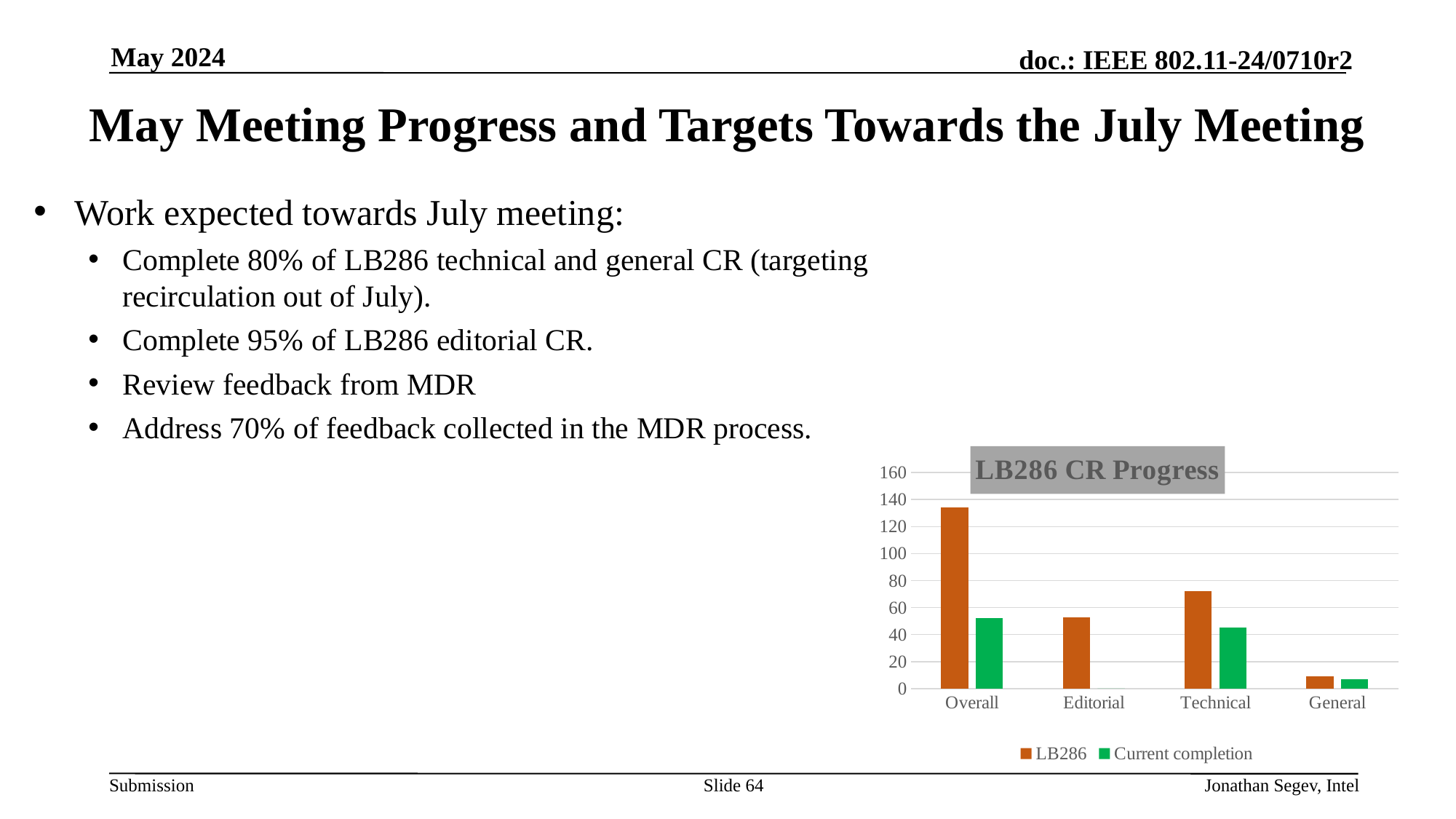
How many series does the legend of the LB286 CR Progress chart list? 2 What kind of chart is the LB286 CR Progress chart? bar chart What is the title of the chart on the slide? LB286 CR Progress Is the LB286 value for Technical greater or less than 60? greater Is the LB286 value for General greater or less than 20? less Is the LB286 value for Overall greater or less than 120? greater Which category has the lowest LB286 value in the LB286 CR Progress chart? General Which colour represents the Current completion series in the LB286 CR Progress chart? green How many categories are shown on the x axis of the LB286 CR Progress chart? 4 Which is larger for Technical: the LB286 value or the Current completion value? LB286 Which category has the highest LB286 value in the LB286 CR Progress chart? Overall